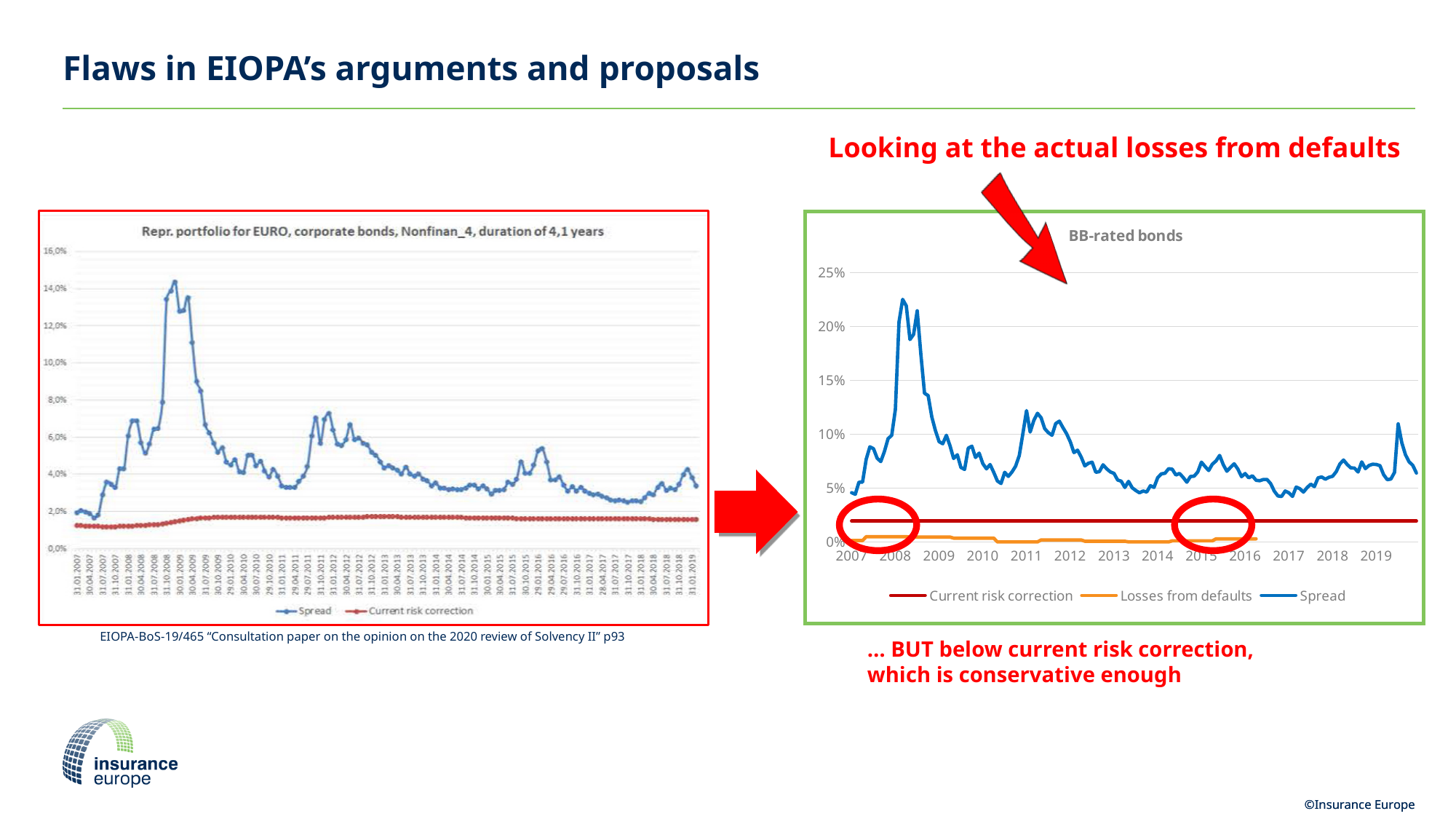
What type of chart is the left chart titled "Repr. portfolio for EURO, corporate bonds, Nonfinan_4, duration of 4,1 years"? Line chart What type of chart is the right chart titled "BB-rated bonds"? Line chart How many series does the legend of the right chart "BB-rated bonds" list? 3 In the right chart "BB-rated bonds", is the Losses from defaults series ever greater or less than 5%? less In the left chart, which series is shown in blue? Spread In the right chart "BB-rated bonds", is the peak value of the Spread series in 2008 greater or less than 20%? greater In the right chart "BB-rated bonds", which series is higher throughout the period: Spread or Losses from defaults? Spread In the left chart, does the Spread series overall rise or fall from its 2008 peak to 2019? Fall How many series does the legend of the left chart list? 2 In the right chart "BB-rated bonds", which series reaches the highest value? Spread In the right chart "BB-rated bonds", which series is shown in orange? Losses from defaults In the left chart, is the peak value of the Spread series around late 2008 greater or less than 12,0%? greater